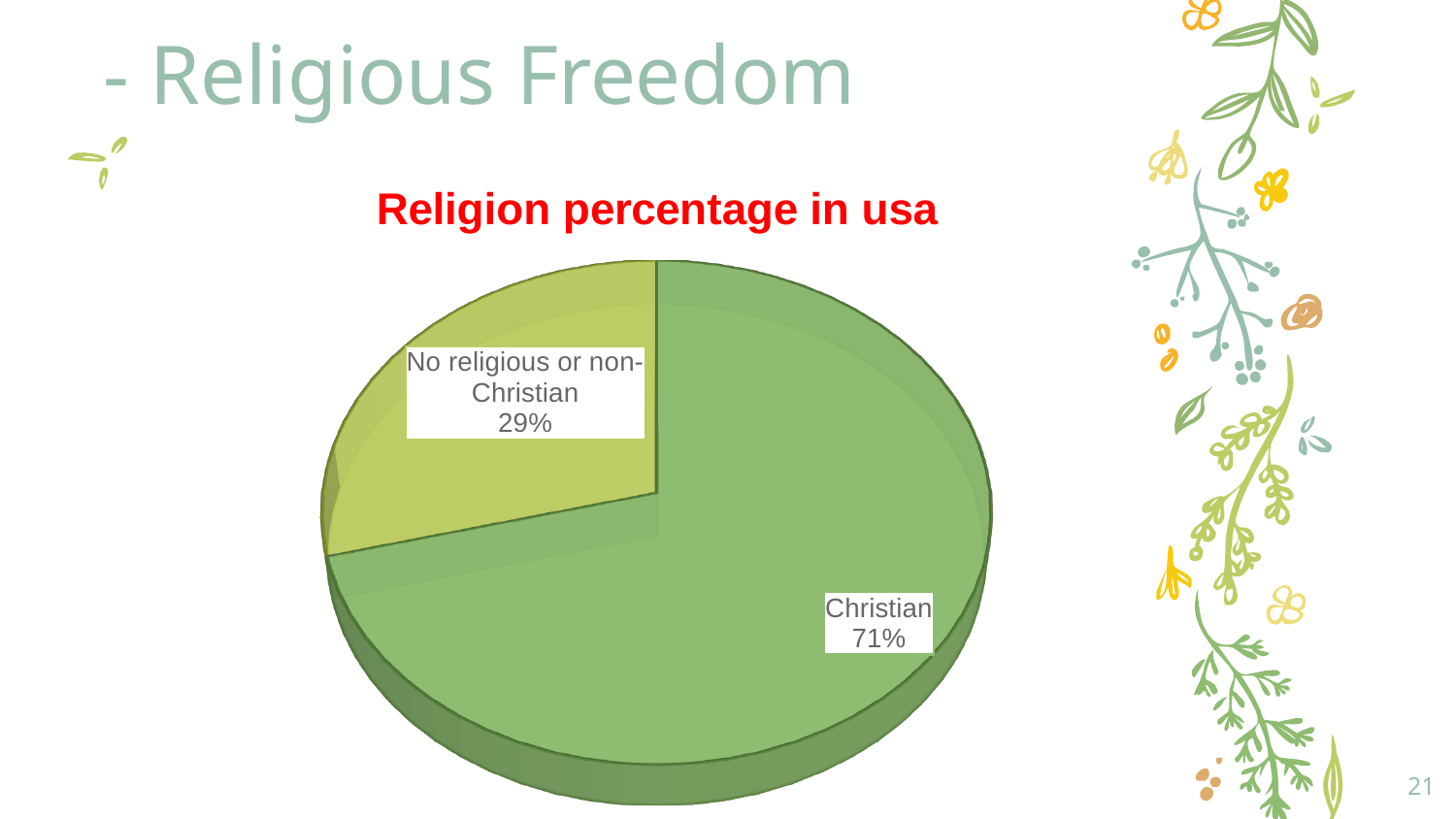
Which is larger, the Christian slice or the 'No religious or non-Christian' slice? Christian What share of the pie does the Christian slice take? 71% What colour is the Christian slice of the pie chart? Green What is the difference in percentage points between the Christian slice and the 'No religious or non-Christian' slice? 42 What is the title of the chart? Religion percentage in usa What type of chart is shown on the slide? Pie chart How many slices does the pie chart have? 2 Which slice of the pie chart is the smallest? No religious or non-Christian What percentage does the Christian slice represent in the pie chart? 71% What percentage does the 'No religious or non-Christian' slice represent? 29% Which slice of the pie chart is the largest? Christian